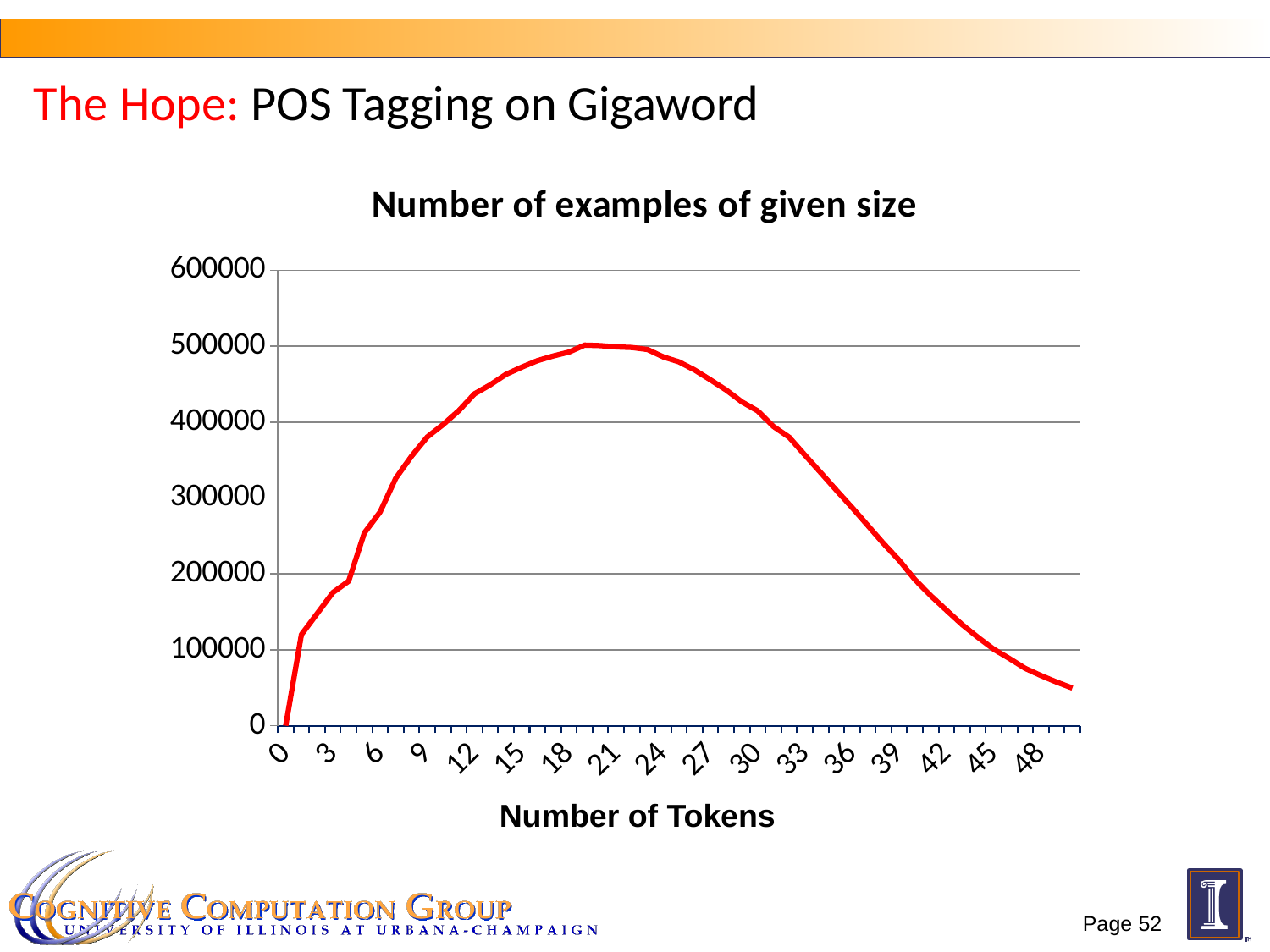
Do the values rise or fall along the x axis from 0 tokens to 18 tokens? rise Which is larger, the value at 21 tokens or the value at 48 tokens? 21 tokens What kind of chart is shown on the slide? line chart Is the value at 42 tokens greater or less than 200000? less What is the label of the x axis? Number of Tokens Is the value at 12 tokens greater or less than 400000? greater Is the value at 3 tokens greater or less than 200000? less What is the title of the chart? Number of examples of given size Do the values rise or fall along the x axis from 24 tokens to 48 tokens? fall